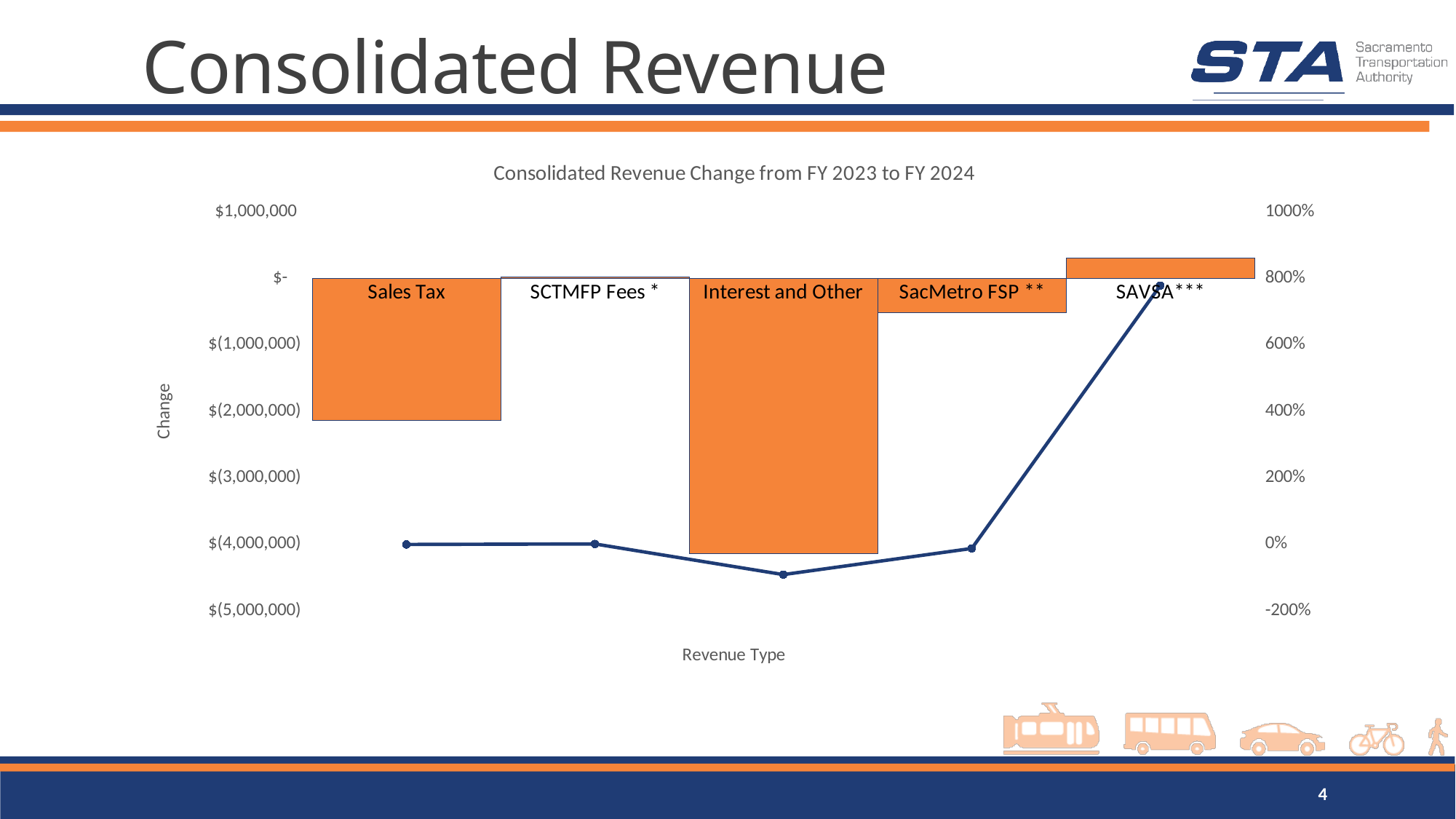
What kind of chart is shown on the slide? Bar chart combined with a line chart What is the title of the chart? Consolidated Revenue Change from FY 2023 to FY 2024 What is the title of the x axis of the chart? Revenue Type Which revenue type has the highest bar in the chart? SAVSA*** Is the percentage change (line) for SAVSA*** greater or less than 600%? greater Is the bar value for SacMetro FSP ** greater or less than $(1,000,000)? greater Which revenue type has the highest point on the percentage change line? SAVSA*** Which revenue type has the lowest (most negative) bar in the chart? Interest and Other Is the bar value for Interest and Other greater or less than $(3,000,000)? less How many revenue types are shown on the x axis of the chart? 5